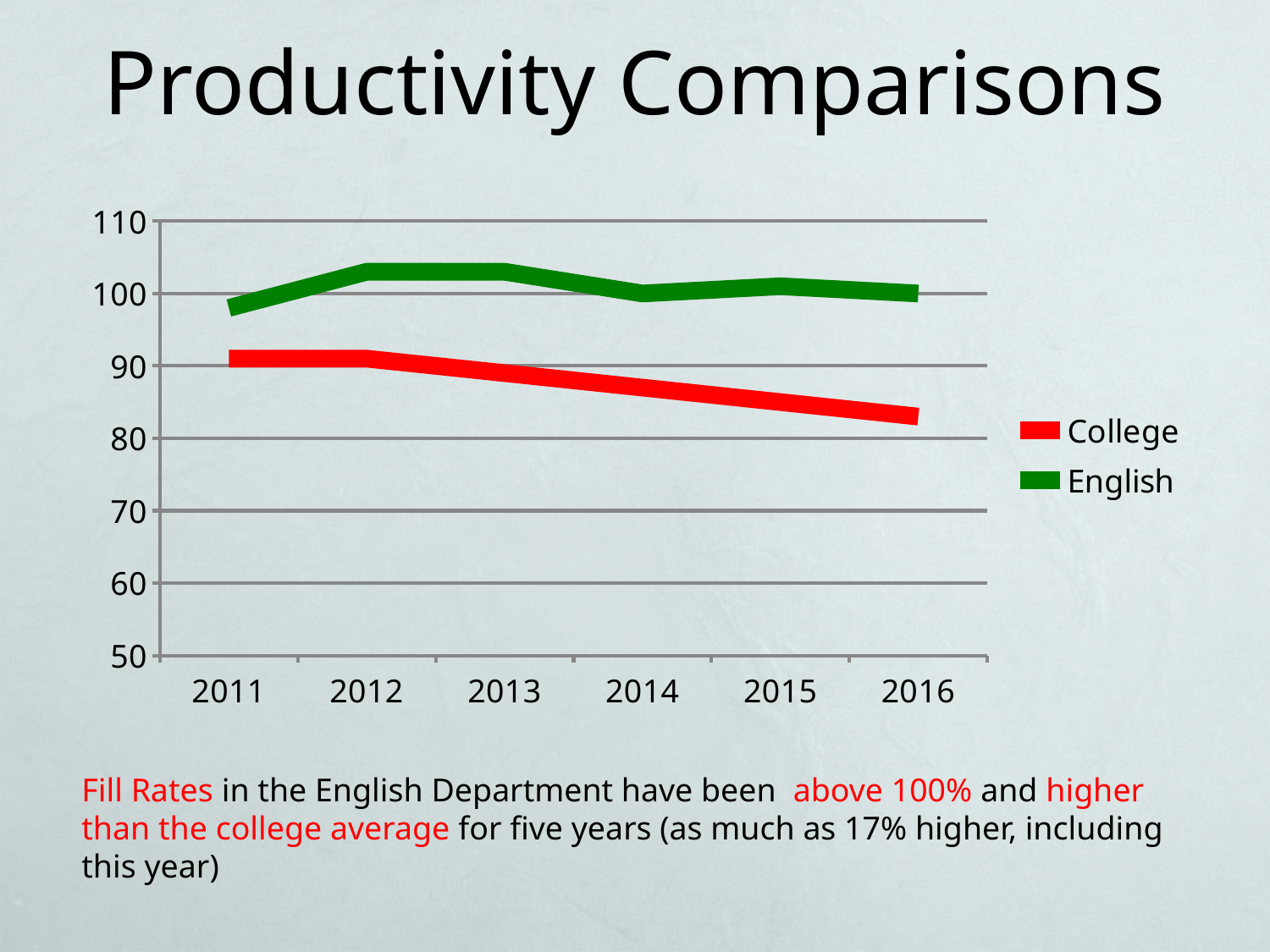
In which year is the College series at its lowest? 2016 What kind of chart is shown on the slide? Line chart What is the title of the chart on the slide? Productivity Comparisons Does the College line rise or fall from 2012 to 2016? Fall How many series does the legend list? 2 In 2013, which series has the higher value, College or English? English Is the value for College in 2016 greater or less than 80? greater Is the value for College in 2014 greater or less than 90? less Is the value for English in 2012 greater or less than 100? greater Which colour represents the English series? Green How many years are shown on the x axis? 6